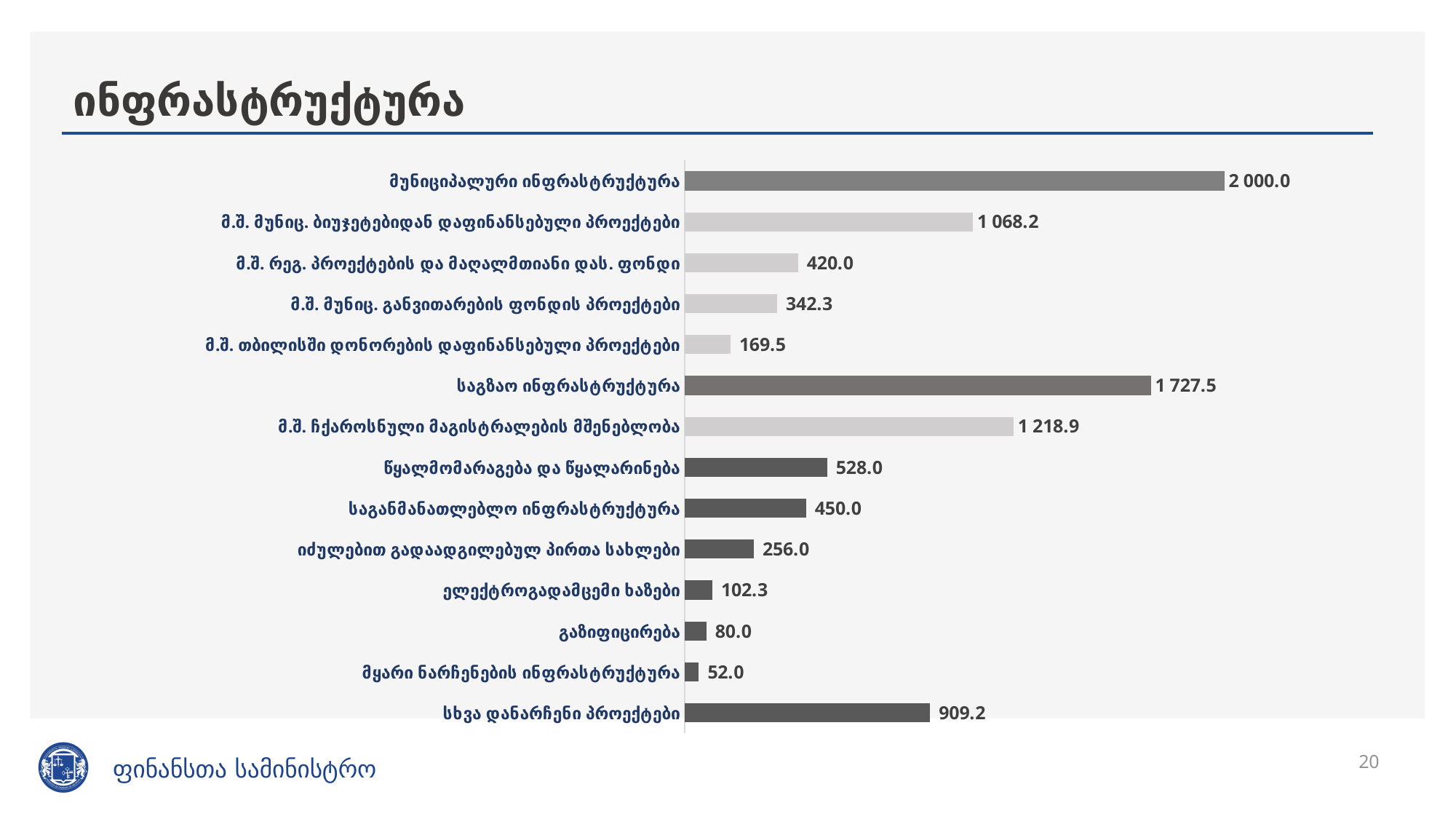
What is the difference between the values for მუნიციპალური ინფრასტრუქტურა and საგზაო ინფრასტრუქტურა? 272.5 Which is larger: the value for წყალმომარაგება და წყალარინება or საგანმანათლებლო ინფრასტრუქტურა? წყალმომარაგება და წყალარინება What is the value for წყალმომარაგება და წყალარინება? 528.0 What is the value for სხვა დანარჩენი პროექტები? 909.2 Which category has the lowest value? მყარი ნარჩენების ინფრასტრუქტურა Which category has the highest value? მუნიციპალური ინფრასტრუქტურა What is the value for მუნიციპალური ინფრასტრუქტურა? 2 000.0 What is the value for საგზაო ინფრასტრუქტურა? 1 727.5 What type of chart is shown on the slide? Bar chart What is the value for გაზიფიცირება? 80.0 What is the title of the slide? ინფრასტრუქტურა How many categories are shown in the chart? 14